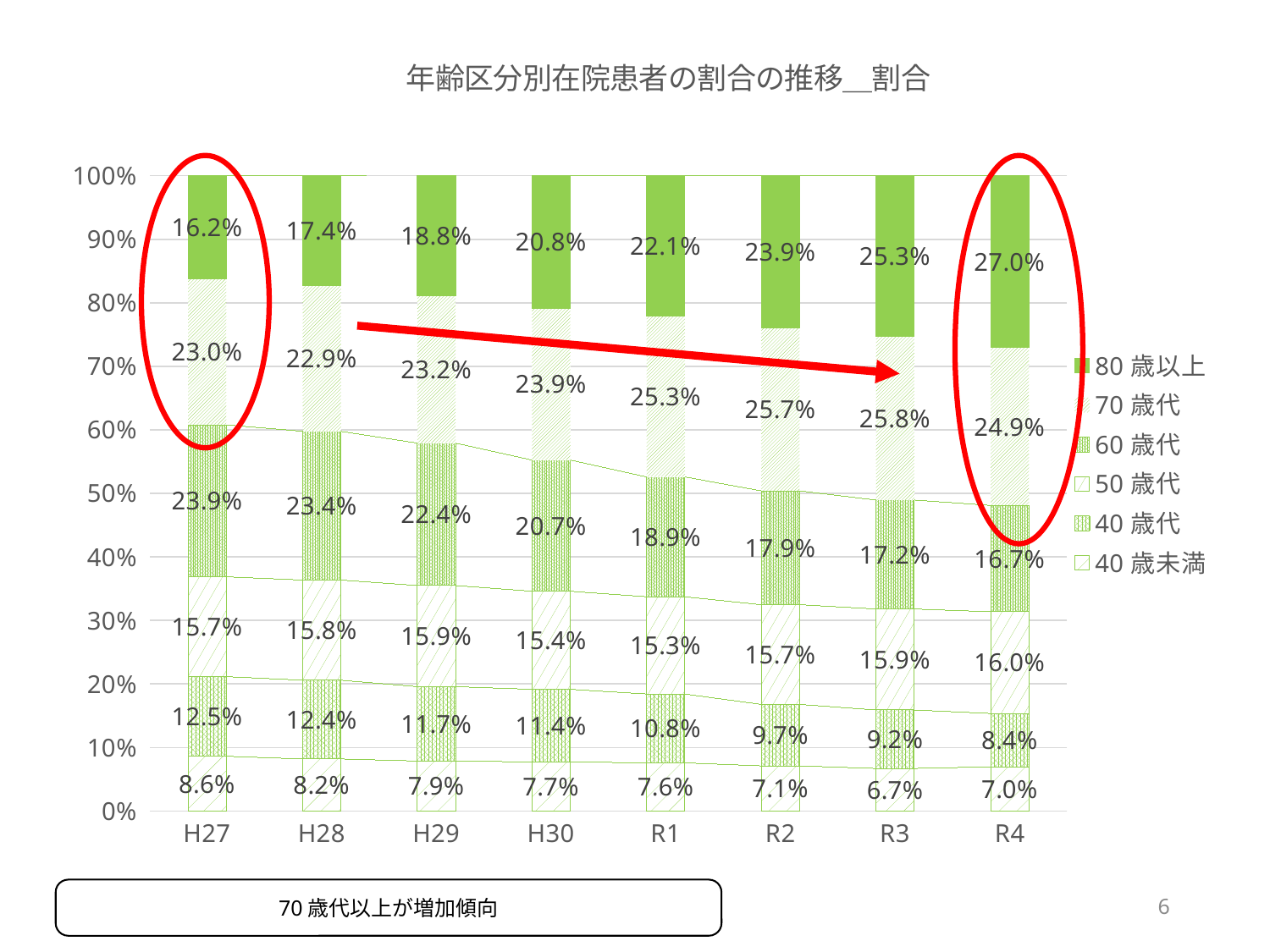
In which year is the 80 歳以上 share highest? R4 What is the value for 40 歳未満 in H27? 8.6% What is the title of the chart? 年齢区分別在院患者の割合の推移＿割合 In which year is the 40 歳未満 share lowest? R3 What is the value for 60 歳代 in H30? 20.7% What is the value for 80 歳以上 in R4? 27.0% How many years are shown on the x axis? 8 What kind of chart is shown on the slide? Stacked bar chart What is the difference between the 80 歳以上 share in R4 and in H27? 10.8% Which is larger in R1: the 70 歳代 share or the 60 歳代 share? 70 歳代 Does the 40 歳代 share rise or fall from H27 to R4? Fall How many series does the legend list? 6